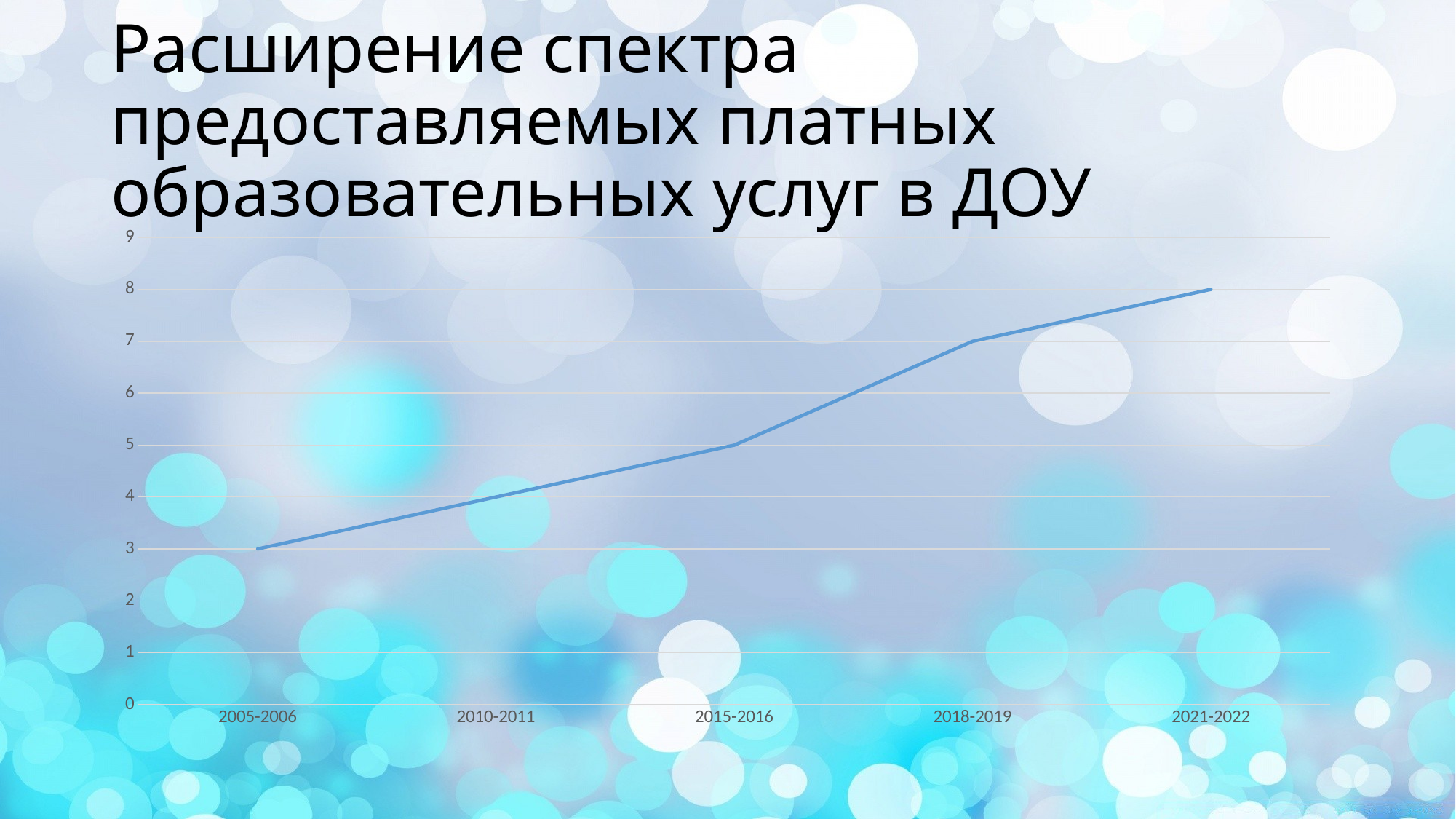
How many data points are plotted on the line? 5 What is the value for 2010-2011? 4 What kind of chart is shown on the slide? line chart Which period has the highest value? 2021-2022 What is the value for 2015-2016? 5 What is the difference between the values for 2021-2022 and 2005-2006? 5 Which period has the lowest value? 2005-2006 What is the value for 2021-2022? 8 Do the values rise or fall from 2005-2006 to 2021-2022? rise Which is larger, the value for 2018-2019 or the value for 2015-2016? 2018-2019 What is the value for 2018-2019? 7 What is the value for 2005-2006? 3